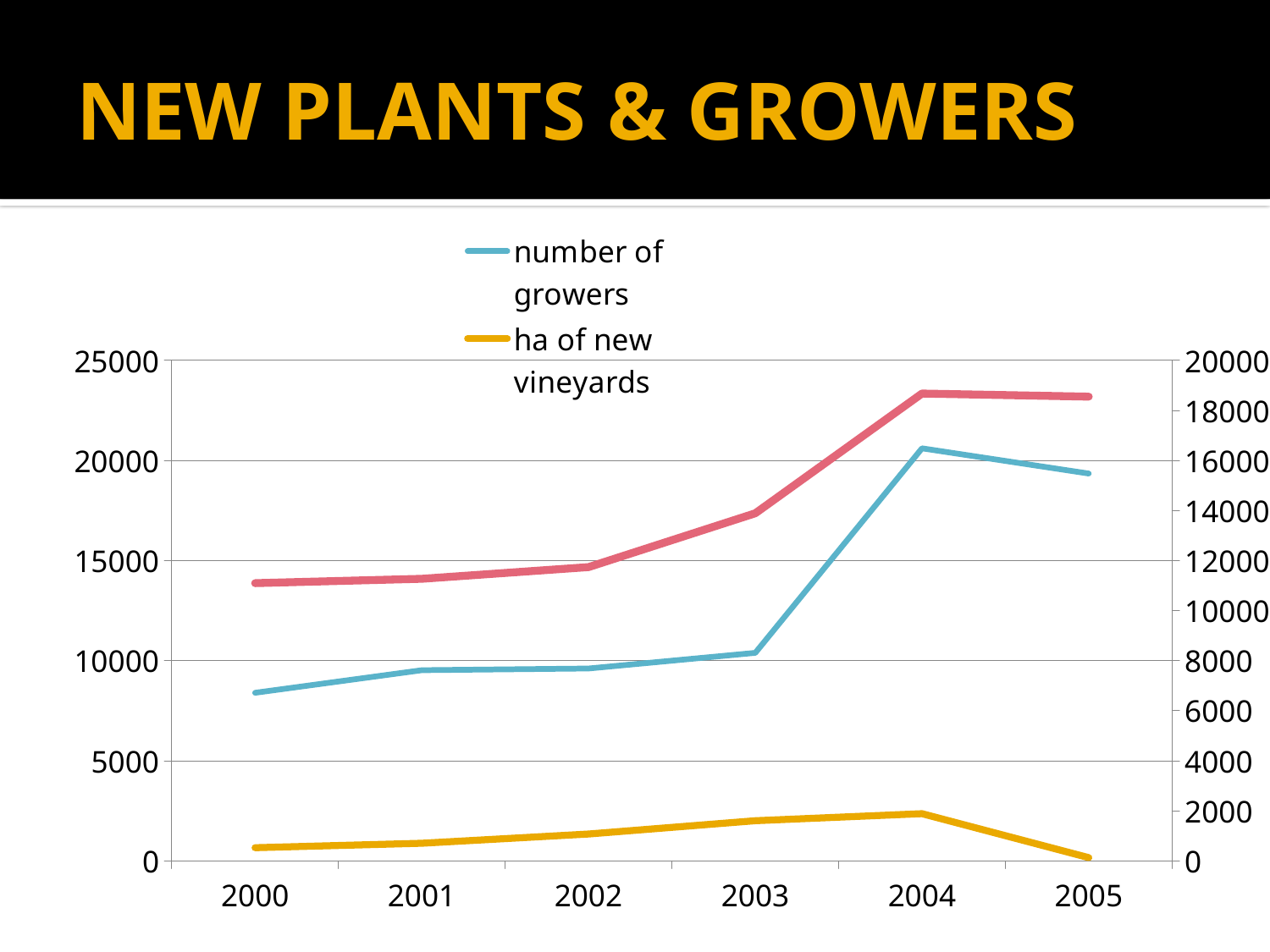
Is the number of growers higher in 2004 or in 2005? 2004 In which year is ha of new vineyards at its lowest? 2005 Is ha of new vineyards higher in 2001 or in 2003? 2003 What kind of chart is shown on the slide? line chart In which year does ha of new vineyards reach its highest point? 2004 Does the number of growers rise or fall from 2000 to 2004? rise Does ha of new vineyards rise or fall from 2004 to 2005? fall How many years are shown on the x axis? 6 How many series does the legend list? 2 What is the title of the slide? NEW PLANTS & GROWERS In which year does the number of growers reach its highest point? 2004 In which year is the number of growers at its lowest? 2000